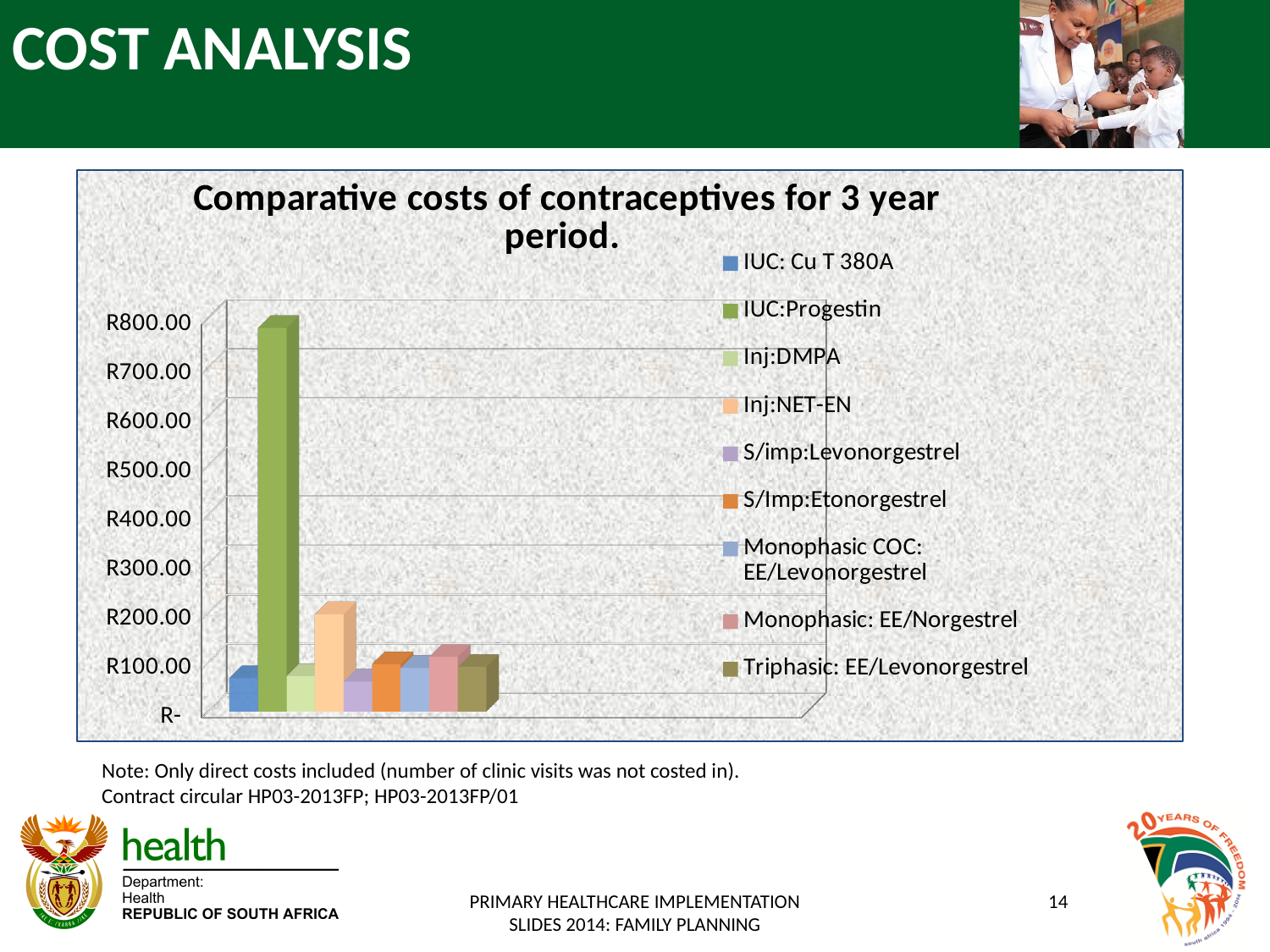
Which is larger, the cost of Inj:NET-EN or the cost of Inj:DMPA? Inj:NET-EN Is the value for Inj:NET-EN greater or less than R300.00? less Is the value for IUC: Cu T 380A greater or less than R100.00? less What type of chart is shown on the slide? bar chart How many bars are plotted in the chart? 9 Is the value for Inj:NET-EN greater or less than R100.00? greater What is the title of the chart? Comparative costs of contraceptives for 3 year period. How many series does the chart legend list? 9 Which contraceptive has the highest cost in the chart? IUC:Progestin Which is larger, the cost of IUC:Progestin or the cost of Inj:NET-EN? IUC:Progestin